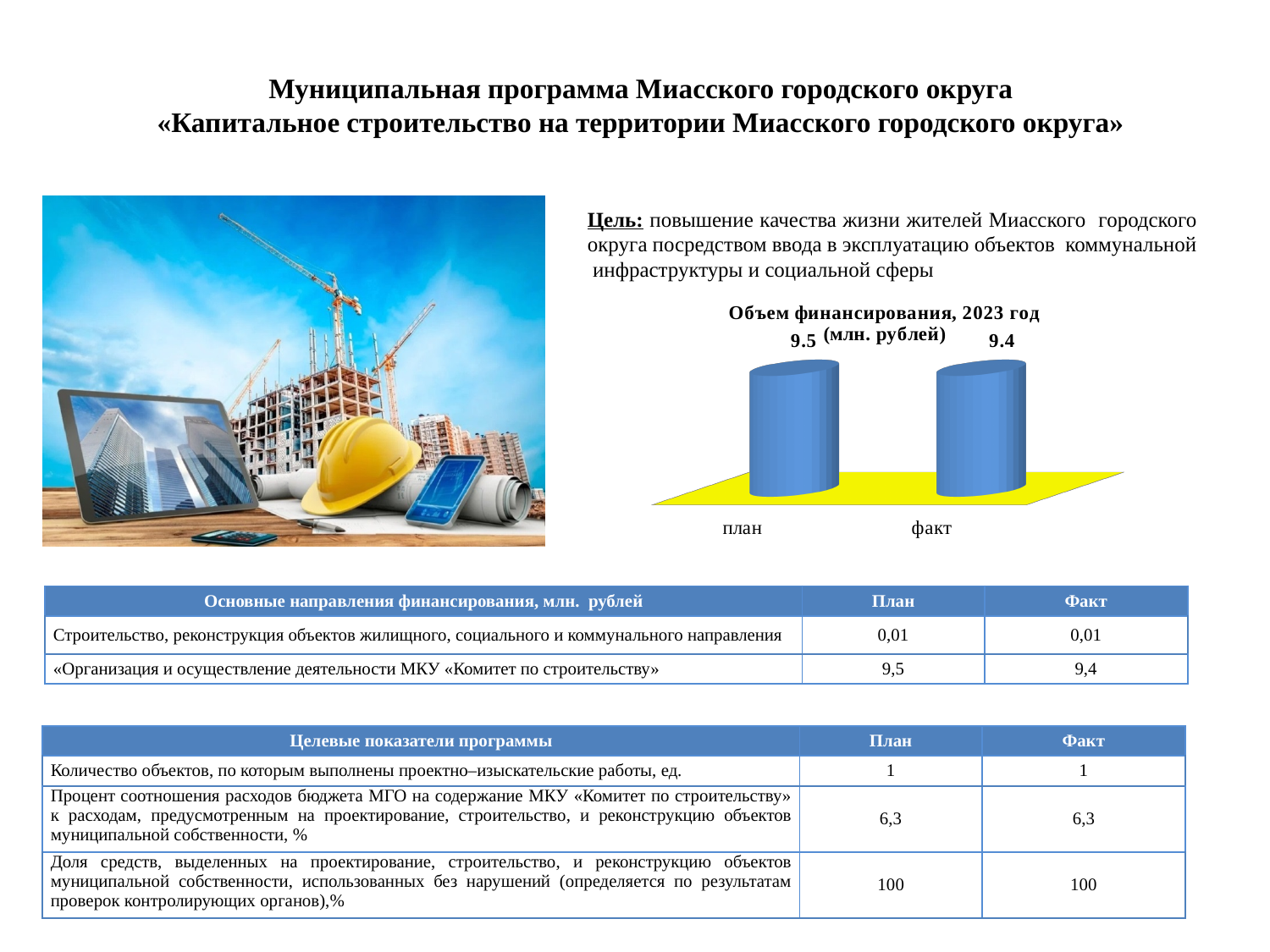
Which category has the higher value in the chart "Объем финансирования, 2023 год"? план What is the value for факт in the chart "Объем финансирования, 2023 год"? 9.4 What is the difference between the план and факт values in the chart "Объем финансирования, 2023 год"? 0.1 Do the values rise or fall from план to факт in the chart "Объем финансирования, 2023 год"? fall What kind of chart is "Объем финансирования, 2023 год"? bar chart What is the value for план in the chart "Объем финансирования, 2023 год"? 9.5 What year does the chart "Объем финансирования" refer to? 2023 How many categories are shown in the chart "Объем финансирования, 2023 год"? 2 Which category has the lower value in the chart "Объем финансирования, 2023 год"? факт What unit is given in the title of the chart "Объем финансирования, 2023 год"? млн. рублей